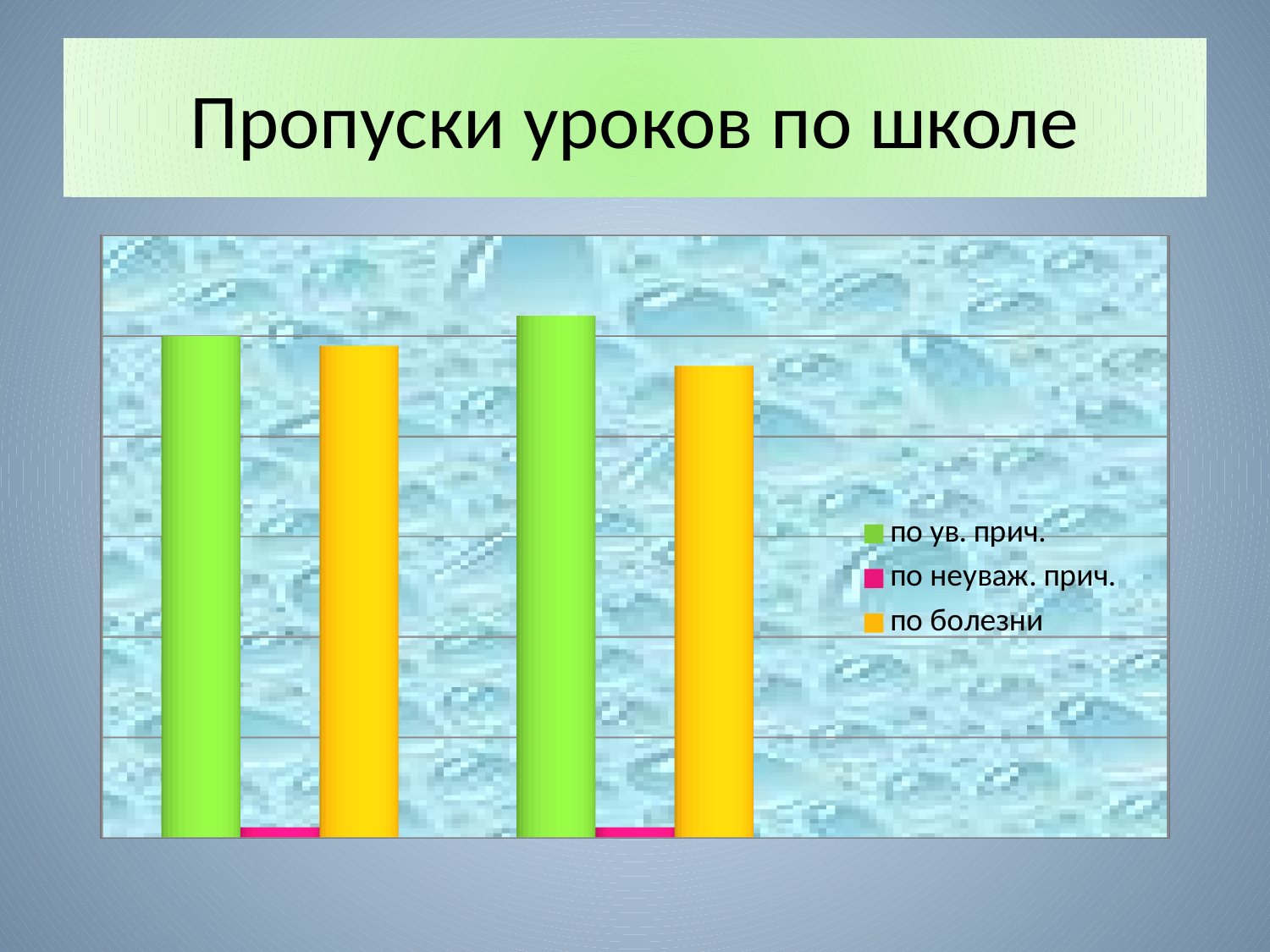
What is the title of the slide containing the chart? Пропуски уроков по школе How many groups of bars are plotted in the chart? 2 Which series has the shortest bars in the chart? по неуваж. прич. Does the bar for по ув. прич. rise or fall from the left group to the right group? rise Which colour represents the series по болезни in the legend? yellow In the right group of bars, which is larger: по ув. прич. or по болезни? по ув. прич. In the left group of bars, which is larger: по болезни or по неуваж. прич.? по болезни Does the bar for по болезни rise or fall from the left group to the right group? fall Which series has the tallest bar in the chart? по ув. прич. What kind of chart is shown on the slide? bar chart In the right group of bars, which is larger: по неуваж. прич. or по ув. прич.? по ув. прич. How many series does the legend list? 3